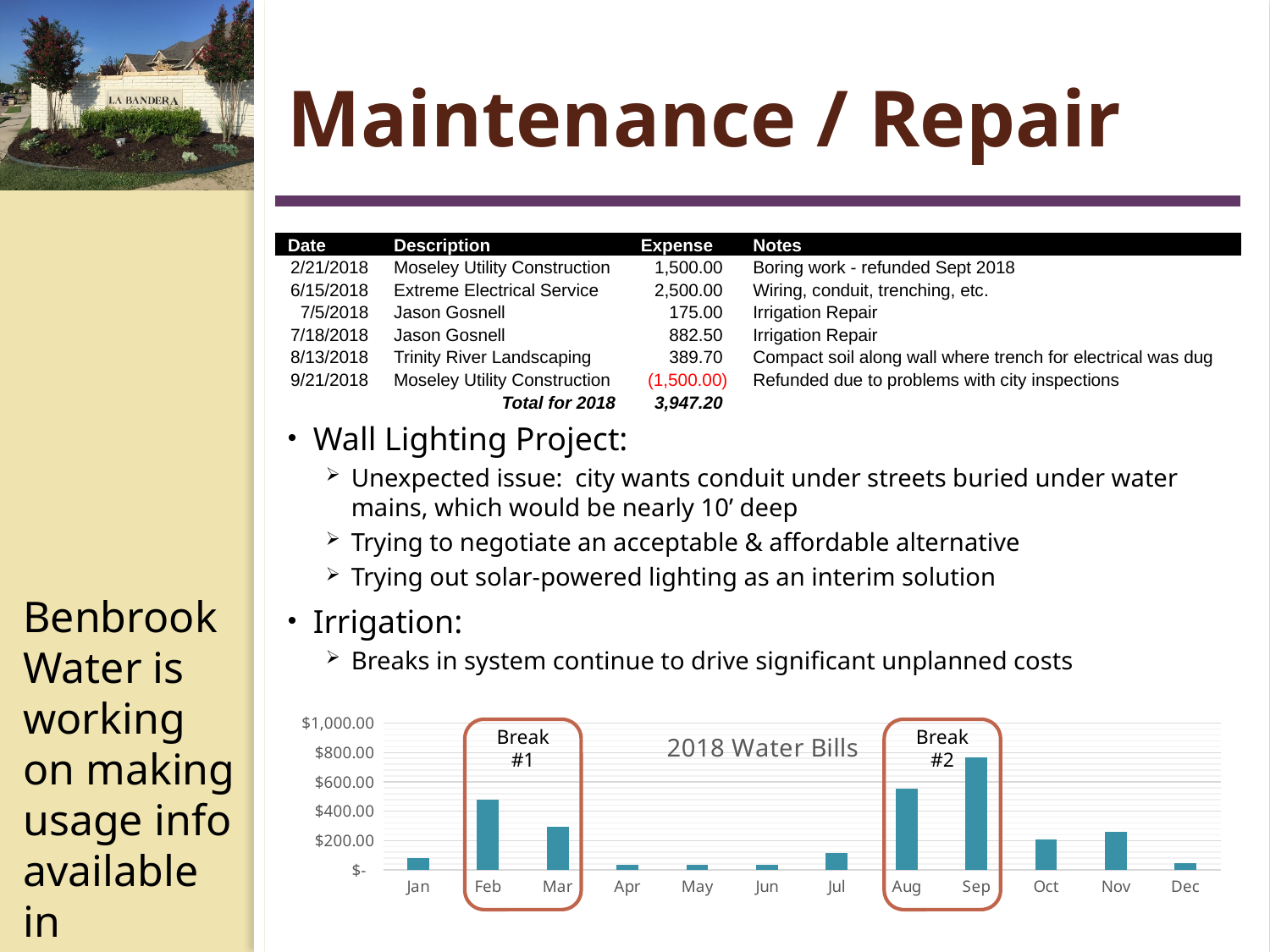
How many months are plotted on the x axis of the chart? 12 Is the value for Sep greater or less than $600.00? greater What label is on the annotation box around the Aug and Sep bars? Break #2 Is the value for Feb greater or less than $400.00? greater Which month has the larger water bill, Aug or Sep? Sep What kind of chart is shown at the bottom of the slide? Bar chart What is the title of the chart? 2018 Water Bills Which month has the highest water bill in the chart? Sep Which month has the larger water bill, Feb or Mar? Feb Is the value for Jan greater or less than $200.00? less